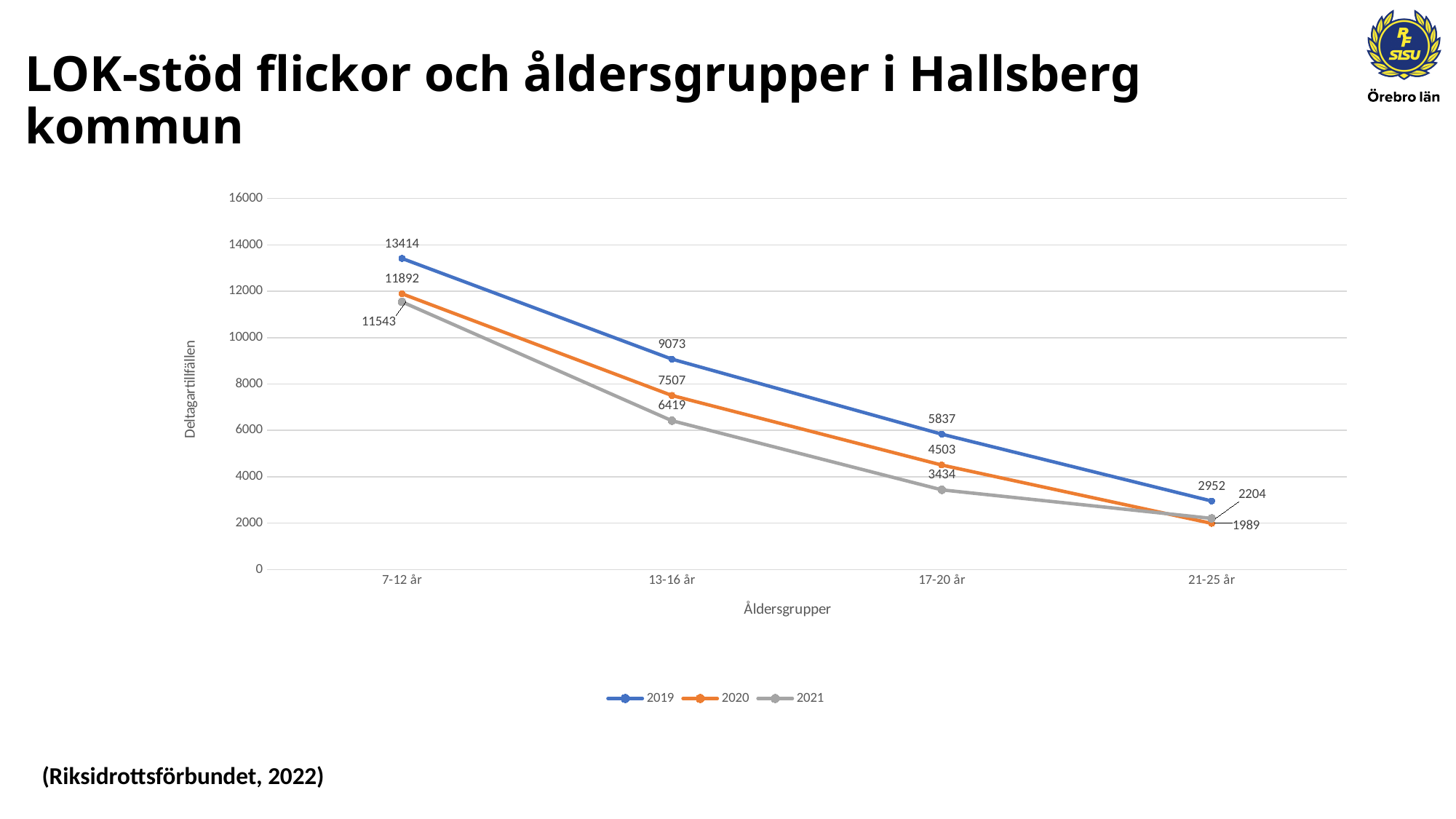
Is the value for 2019 in the 17-20 år age group greater or less than 4000? greater What kind of chart is shown on the slide? line chart In the 21-25 år age group, which series has the larger value, 2020 or 2021? 2021 What is the value for 2019 in the 7-12 år age group? 13414 What is the difference between the 2019 and 2021 values in the 13-16 år age group? 2654 How many age groups are shown on the x axis? 4 What is the value for 2021 in the 13-16 år age group? 6419 Which age group has the lowest value for the 2019 series? 21-25 år Which age group has the highest value for the 2020 series? 7-12 år How many series does the legend list? 3 Do the values for the 2021 series rise or fall from 7-12 år to 21-25 år? fall What is the value for 2020 in the 17-20 år age group? 4503